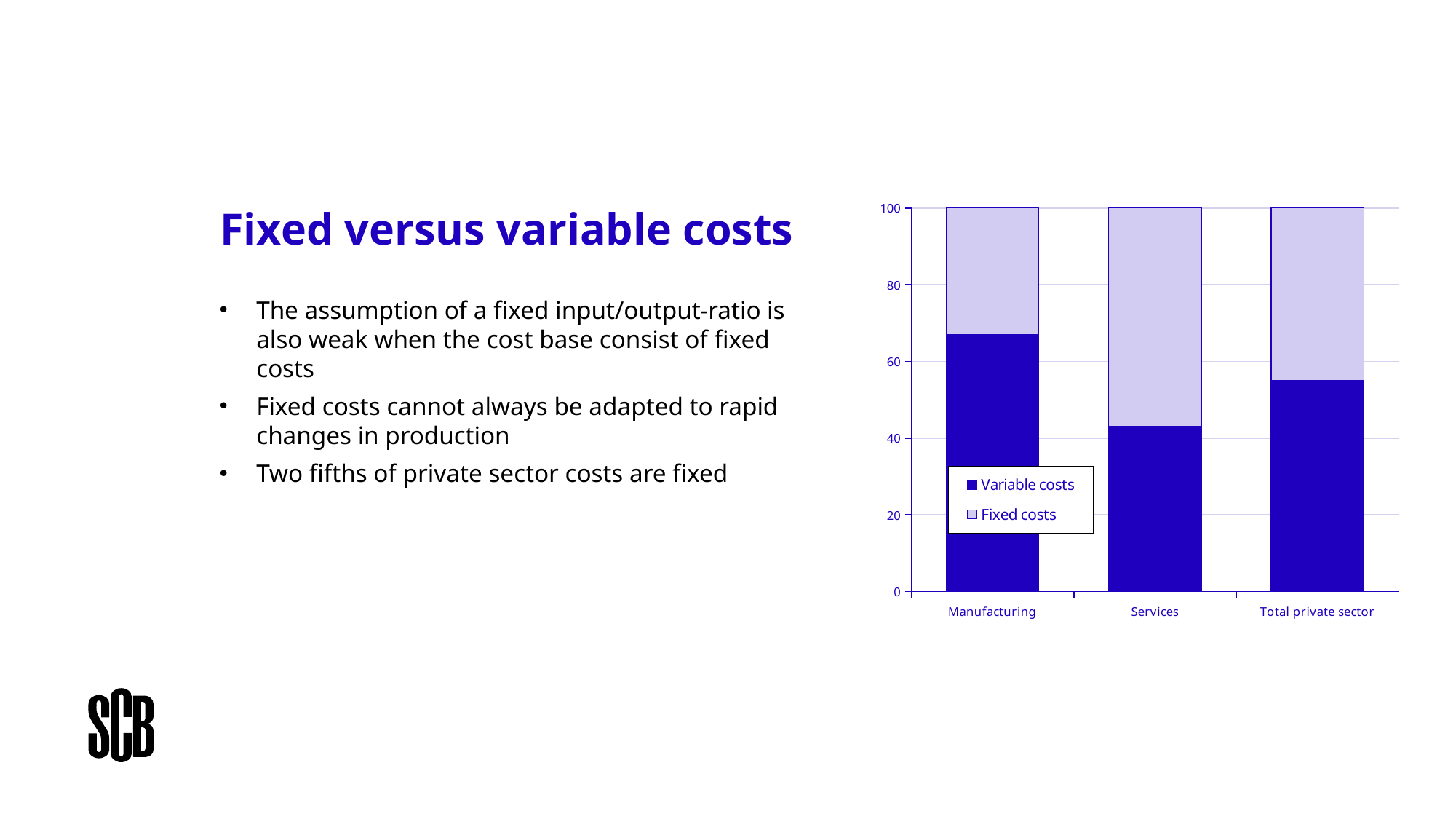
Which is larger: Variable costs for Manufacturing or Variable costs for Total private sector? Manufacturing Is the Variable costs value for Services greater or less than 60? less Which category has the largest Fixed costs share? Services How many series does the chart's legend list? 2 Which series are listed in the chart's legend? Variable costs and Fixed costs Is the Variable costs value for Total private sector greater or less than 40? greater Is the Variable costs value for Manufacturing greater or less than 60? greater What kind of chart is shown on the slide? Stacked bar chart Which category has the highest value for Variable costs? Manufacturing How many categories are shown on the x axis of the chart? 3 Which category has the lowest value for Variable costs? Services What is the total height of each stacked bar in the chart? 100